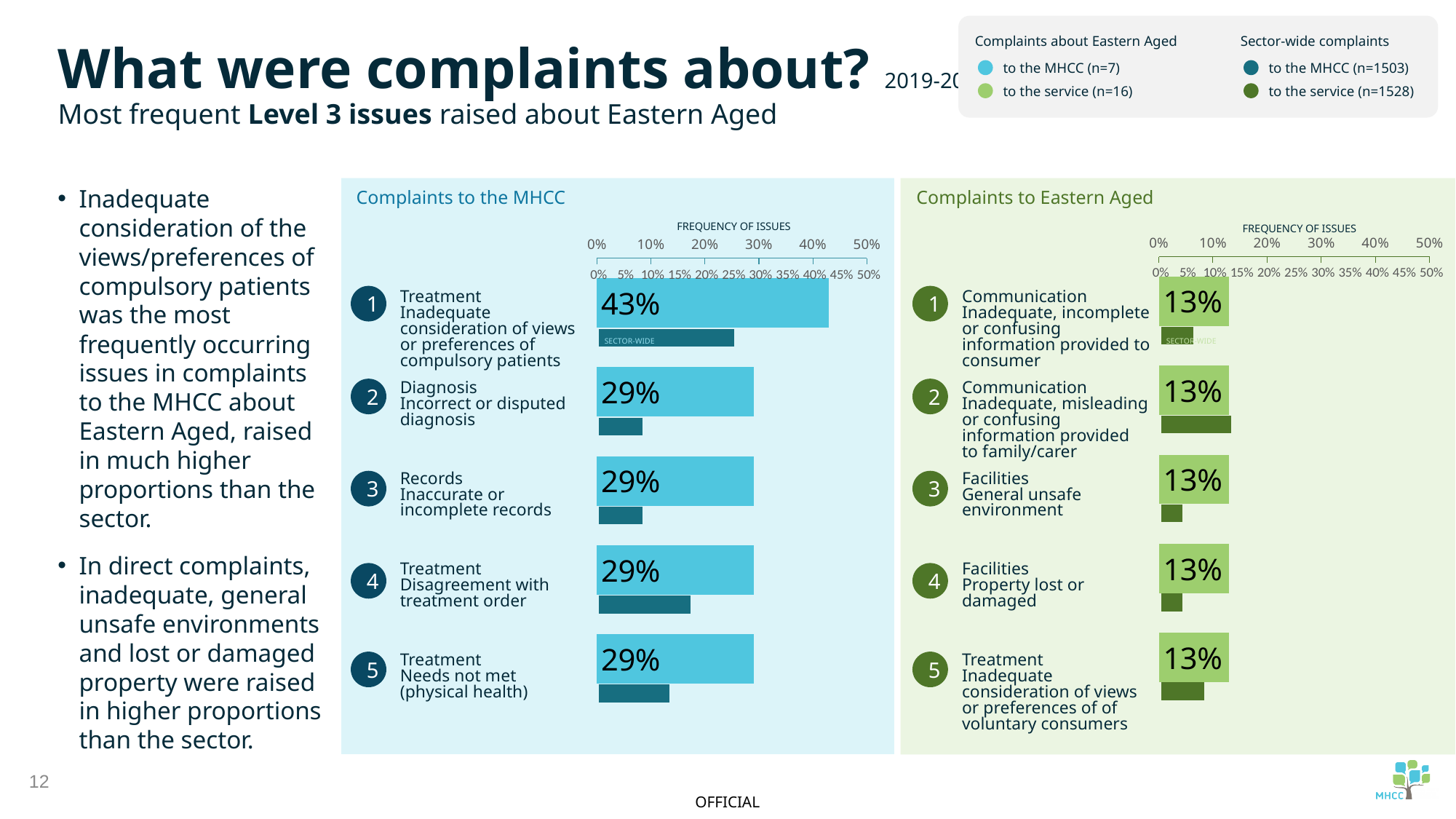
In the 'Complaints to the MHCC' chart, what is the frequency of issues for 'Treatment – Inadequate consideration of views or preferences of compulsory patients'? 43% In the 'Complaints to Eastern Aged' chart, what is the frequency of issues for 'Facilities – General unsafe environment'? 13% In the 'Complaints to Eastern Aged' chart, which is larger for 'Facilities – General unsafe environment': the Eastern Aged value or the sector-wide value? The Eastern Aged value How many issues are listed in the 'Complaints to the MHCC' chart? 5 How many issues are listed in the 'Complaints to Eastern Aged' chart? 5 In the 'Complaints to the MHCC' chart, is the sector-wide value for 'Treatment – Inadequate consideration of views or preferences of compulsory patients' greater or less than 30%? less In the 'Complaints to the MHCC' chart, what is the difference between the frequency for 'Treatment – Inadequate consideration of views or preferences of compulsory patients' and 'Records – Inaccurate or incomplete records'? 14 percentage points What type of chart is used in the 'Complaints to the MHCC' panel? Bar chart In the 'Complaints to the MHCC' chart, is the sector-wide value for 'Treatment – Disagreement with treatment order' greater or less than 10%? greater In the 'Complaints to the MHCC' chart, which issue has the highest frequency? Treatment – Inadequate consideration of views or preferences of compulsory patients According to the legend, how many complaints about Eastern Aged were made to the MHCC? n=7 In the 'Complaints to the MHCC' chart, what is the frequency of issues for 'Diagnosis – Incorrect or disputed diagnosis'? 29%